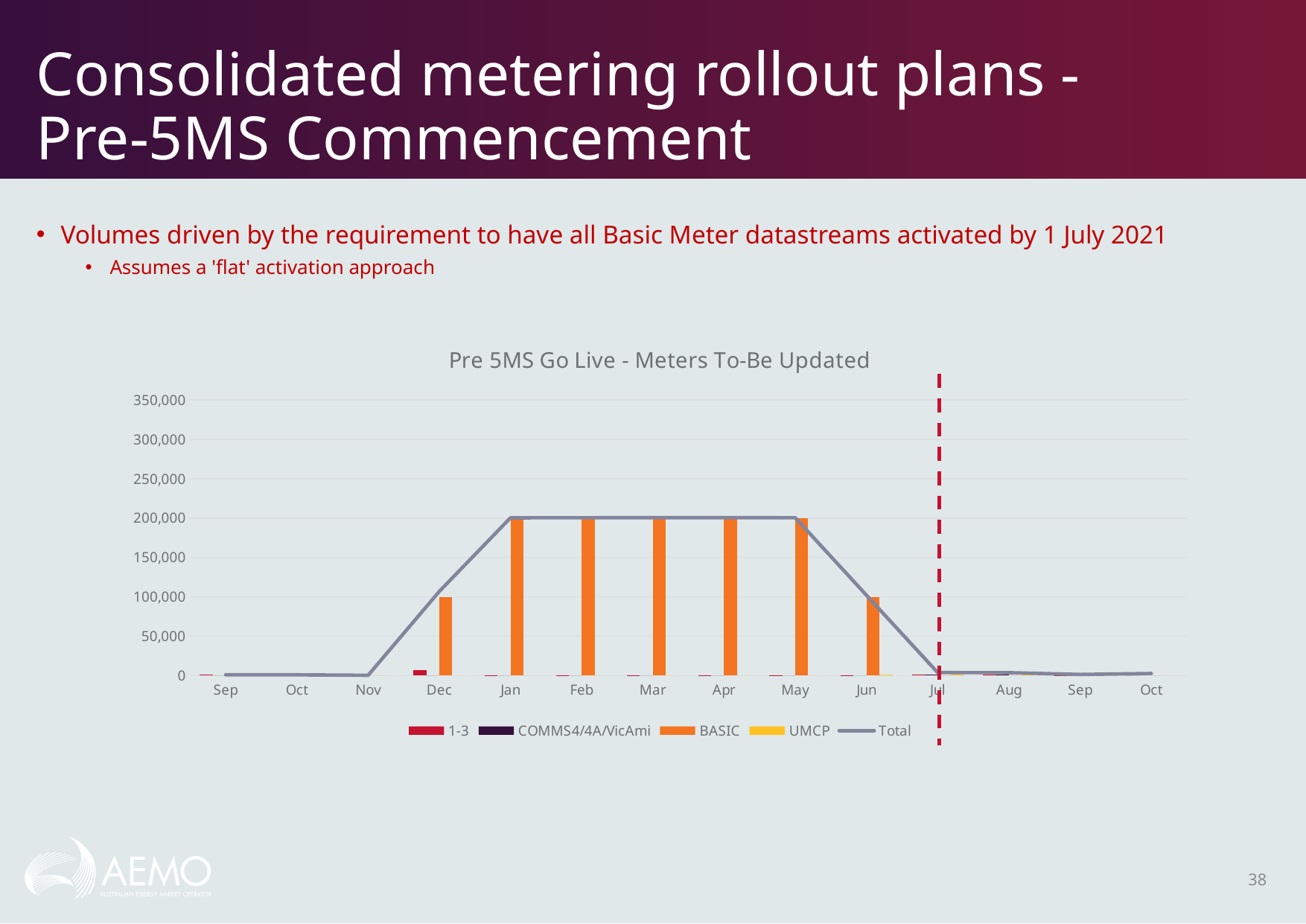
Is the BASIC value for Jun greater or less than 150,000? less Which is larger, the BASIC value for Mar or for Jun? Mar Does the Total line rise or fall between May and Jul? fall What kind of chart is shown on the slide? Combined bar and line chart Which series is drawn as a line rather than bars? Total What is the title of the chart? Pre 5MS Go Live - Meters To-Be Updated How many months are shown along the x axis of the chart? 14 How many series does the chart legend list? 5